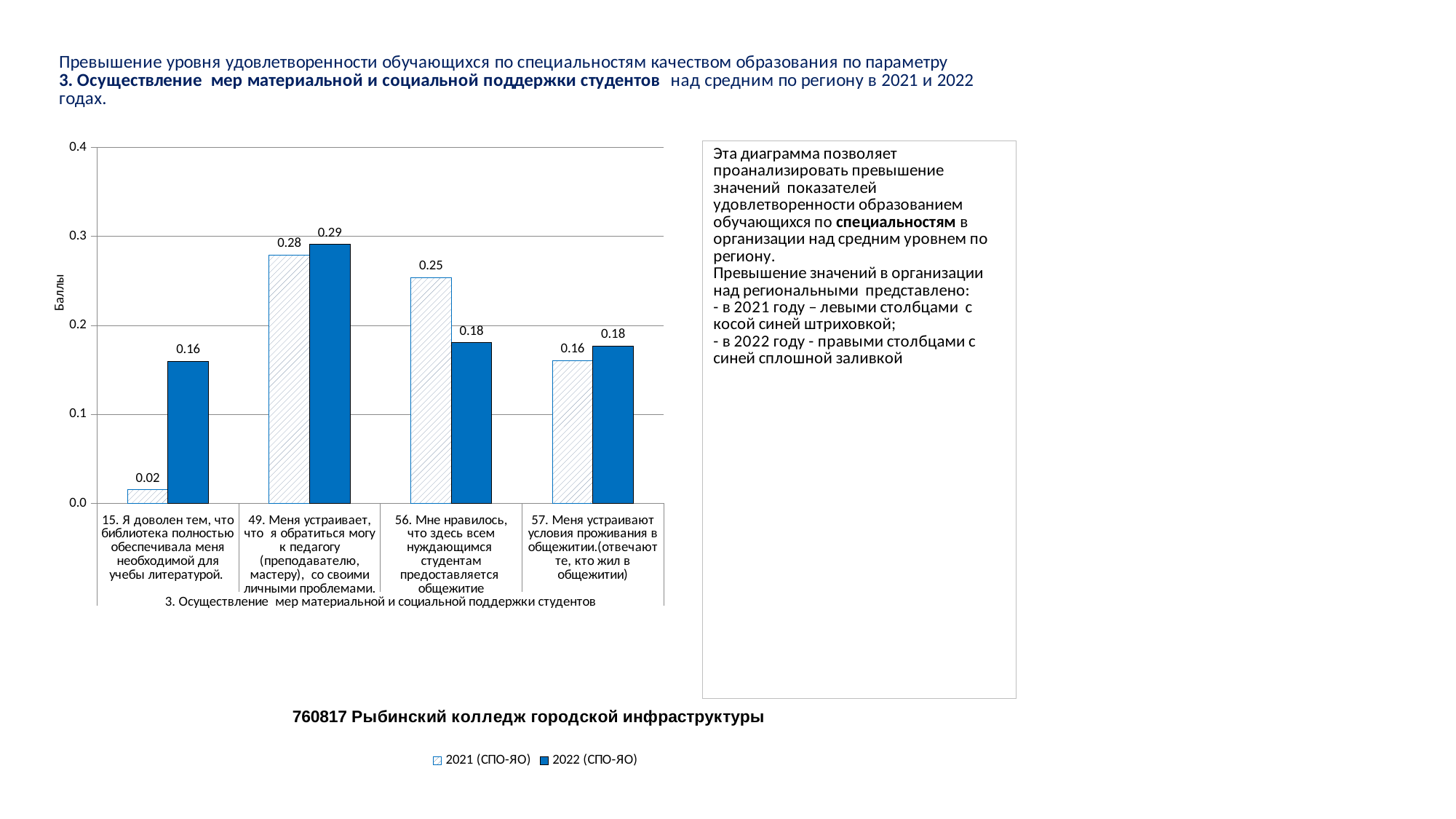
Which category has the highest 2022 (СПО-ЯО) value? 49. Меня устраивает, что я обратиться могу к педагогу What is the 2022 (СПО-ЯО) value for category 57 (Меня устраивают условия проживания в общежитии)? 0.18 What is the 2021 (СПО-ЯО) value for category 15 (Я доволен тем, что библиотека полностью обеспечивала меня необходимой для учебы литературой)? 0.02 Which category has the lowest 2021 (СПО-ЯО) value? 15. Я доволен тем, что библиотека полностью обеспечивала меня необходимой для учебы литературой What type of chart is shown on the slide? bar chart How many series does the legend list? 2 What is the label of the y axis of the chart? Баллы What is the 2022 (СПО-ЯО) value for category 49 (Меня устраивает, что я обратиться могу к педагогу)? 0.29 For category 56, which series has the larger value, 2021 (СПО-ЯО) or 2022 (СПО-ЯО)? 2021 (СПО-ЯО) What is the 2021 (СПО-ЯО) value for category 56 (Мне нравилось, что здесь всем нуждающимся студентам предоставляется общежитие)? 0.25 How many categories are shown on the x axis of the chart? 4 What is the difference between the 2022 (СПО-ЯО) and 2021 (СПО-ЯО) values for category 15? 0.14